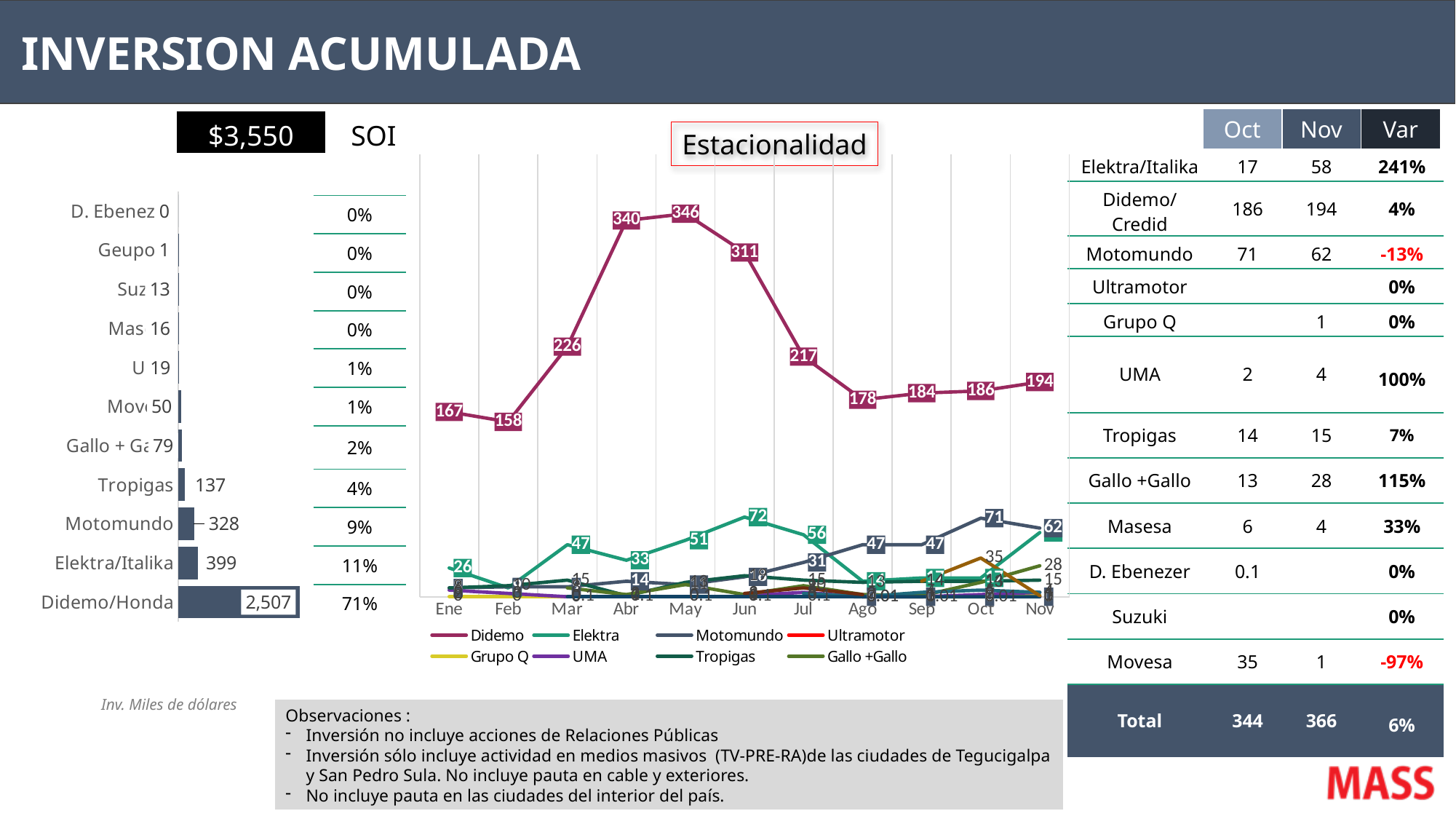
In the bar chart on the left, which category has the highest value? Didemo/Honda In the 'Estacionalidad' chart, in which month does the Didemo series have its lowest value? Feb How many series does the legend of the 'Estacionalidad' chart list? 8 In the 'Estacionalidad' chart, what is the value of the Didemo series in May? 346 In the bar chart on the left, what is the value for Didemo/Honda? 2,507 What kind of chart is the chart on the left of the slide, next to the $3,550 SOI label? bar chart In the bar chart on the left, what is the difference between the values for Elektra/Italika and Motomundo? 71 What kind of chart is the 'Estacionalidad' chart? line chart How many months are shown on the x axis of the 'Estacionalidad' chart? 11 In the 'Estacionalidad' chart, does the Didemo series rise or fall from May to Ago? fall In the 'Estacionalidad' chart, in which month does the Didemo series reach its highest value? May In the bar chart on the left, what is the value for Motomundo? 328